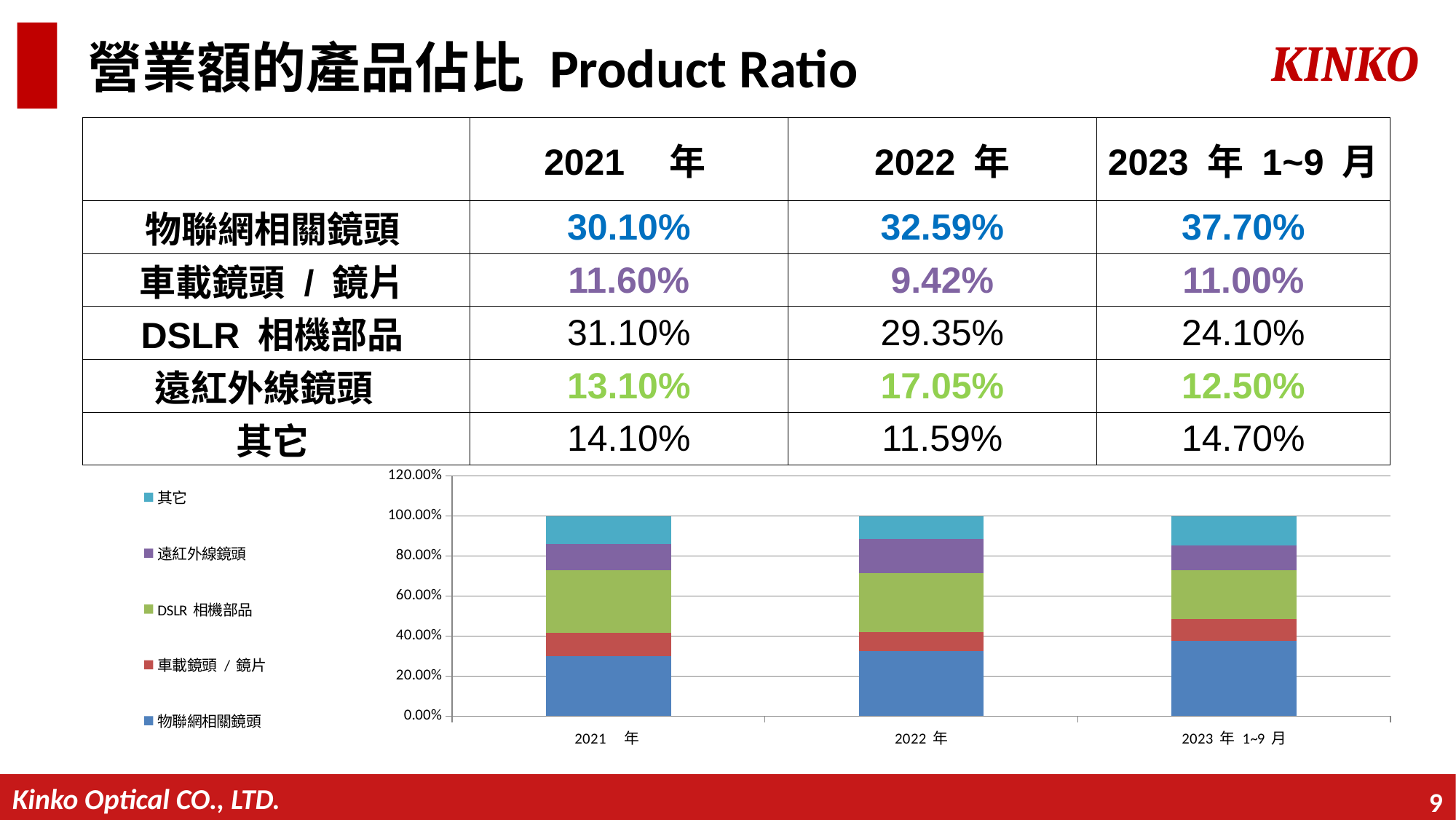
What kind of chart is shown on the slide? Stacked bar chart How many periods (bars) are shown on the x axis of the chart? 3 In which period is the share of 物聯網相關鏡頭 the highest? 2023 年 1~9 月 What is the total of the stacked bar for 2022 年? 100.00% How many series does the chart legend list? 5 What is the share of 遠紅外線鏡頭 in 2022 年? 17.05% What is the share of 物聯網相關鏡頭 in 2023 年 1~9 月? 37.70% Does the share of 物聯網相關鏡頭 rise or fall across the three periods on the x axis? Rises In 2021 年, which is larger: the share of DSLR 相機部品 or the share of 物聯網相關鏡頭? DSLR 相機部品 By how many percentage points did the share of DSLR 相機部品 fall from 2021 年 to 2023 年 1~9 月? 7.00 percentage points Which colour represents 物聯網相關鏡頭 in the chart? Blue In which period is the share of 車載鏡頭 / 鏡片 the lowest? 2022 年